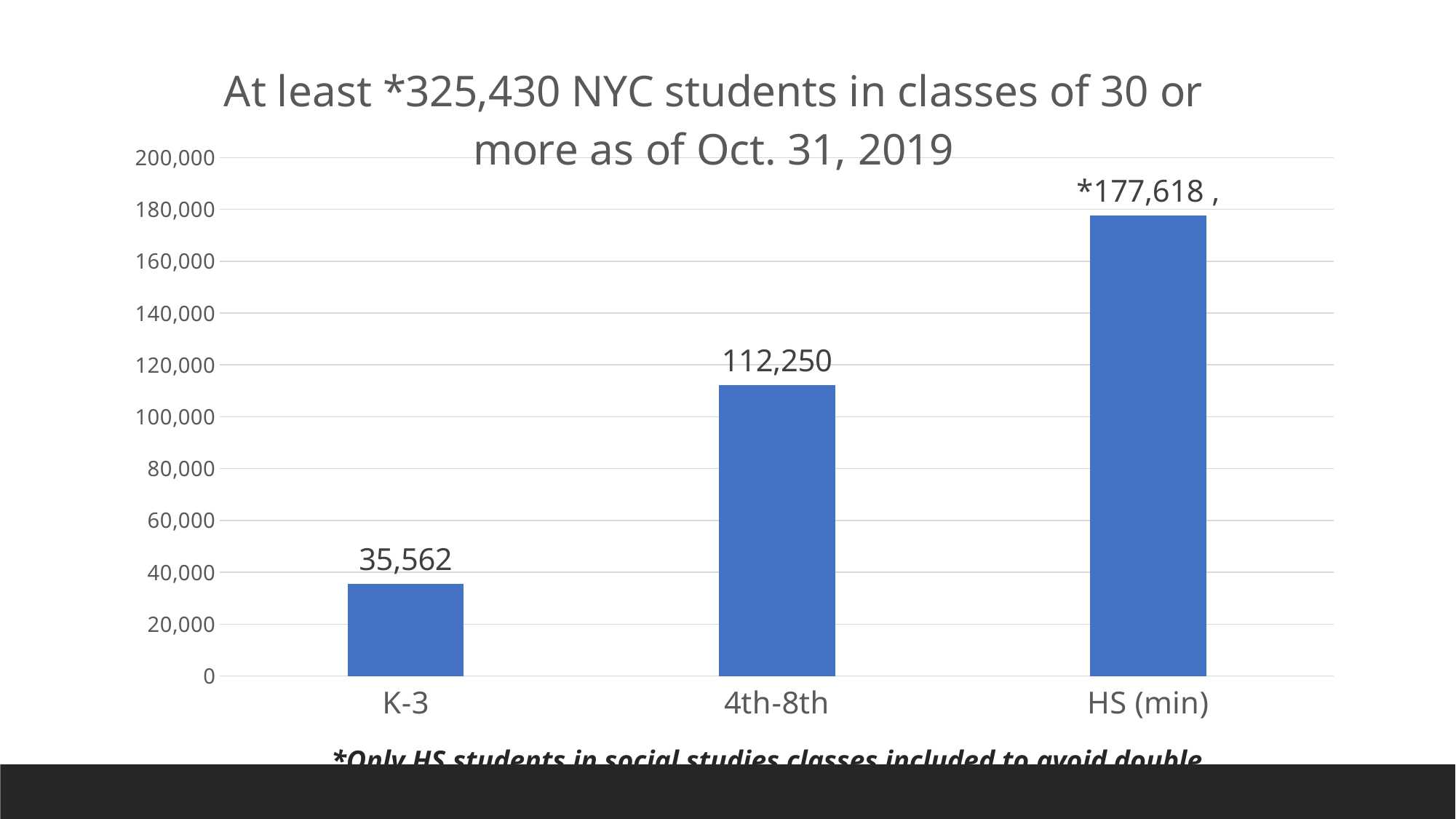
Which category has the highest value? HS (min) Is the value for 4th-8th greater or less than 100,000? greater What is the value shown for HS (min)? 177,618 What is the difference between the values for 4th-8th and K-3? 76,688 What is the difference between the values for HS (min) and 4th-8th? 65,368 What is the value for K-3? 35,562 Which category has the lowest value? K-3 How many categories are shown on the x axis? 3 What kind of chart is shown on the slide? bar chart Which is larger, the value for 4th-8th or the value for K-3? 4th-8th Do the values rise or fall from K-3 to HS (min) along the x axis? rise What is the value for 4th-8th? 112,250